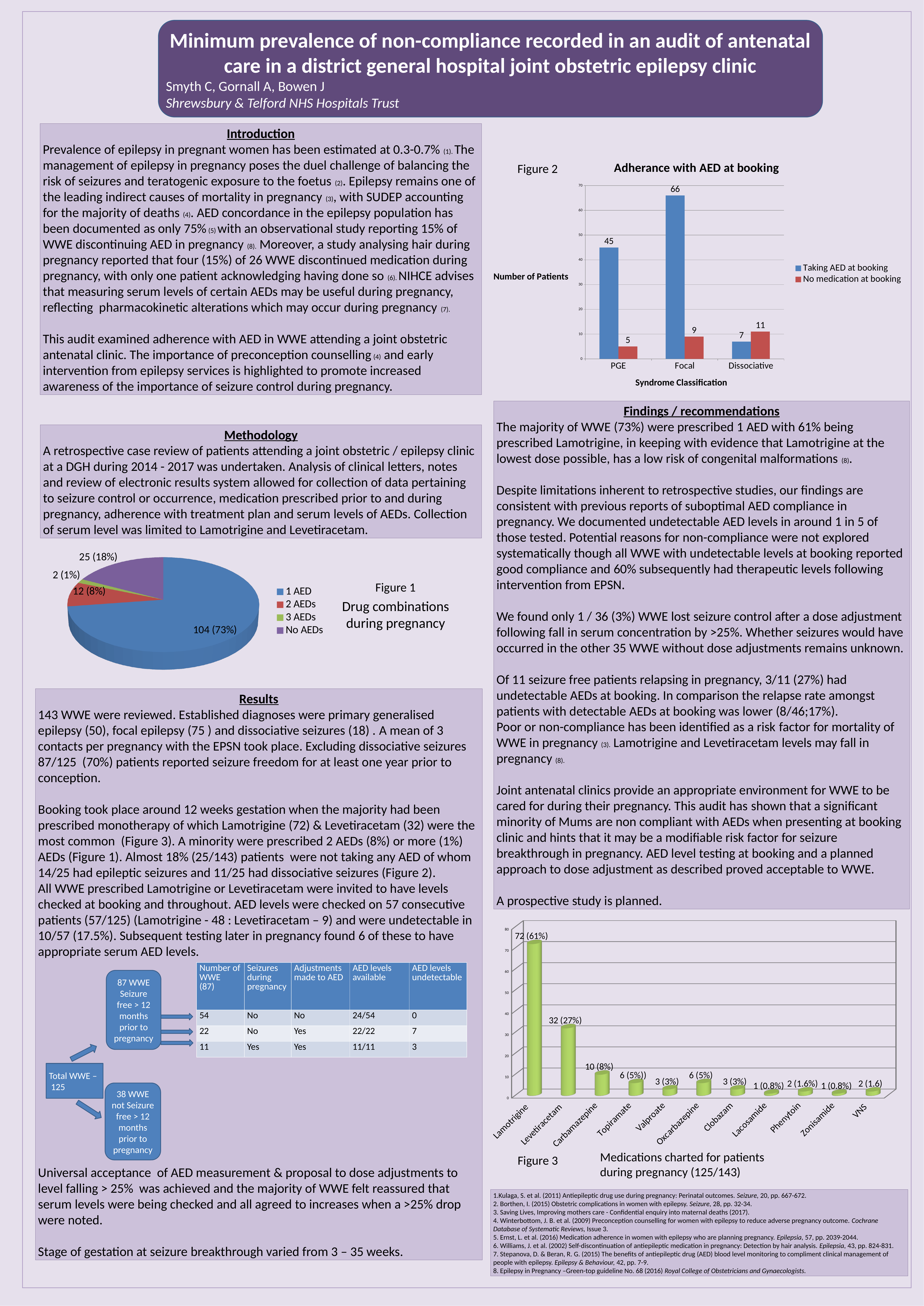
In the Figure 3 chart 'Medications charted for patients during pregnancy', how many medication categories are shown on the x axis? 11 In the Figure 2 chart 'Adherance with AED at booking', how many PGE patients had no medication at booking? 5 In the Figure 2 chart 'Adherance with AED at booking', how many series does the legend list? 2 In the Figure 2 chart 'Adherance with AED at booking', what is the difference between the number of Dissociative patients with no medication at booking and those taking AED at booking? 4 In the Figure 1 pie chart 'Drug combinations during pregnancy', what is the value shown for 1 AED? 104 (73%) In the Figure 3 chart 'Medications charted for patients during pregnancy', what is the value shown for Levetiracetam? 32 (27%) In the Figure 2 chart 'Adherance with AED at booking', how many patients with Focal epilepsy were taking AED at booking? 66 In the Figure 1 pie chart 'Drug combinations during pregnancy', how many slices are there? 4 In the Figure 3 chart 'Medications charted for patients during pregnancy', which medication has the highest value? Lamotrigine In the Figure 1 pie chart 'Drug combinations during pregnancy', what share of the pie is No AEDs? 18% In the Figure 2 chart 'Adherance with AED at booking', which syndrome classification has the highest number of patients taking AED at booking? Focal In the Figure 2 chart 'Adherance with AED at booking', what is the label on the x axis? Syndrome Classification